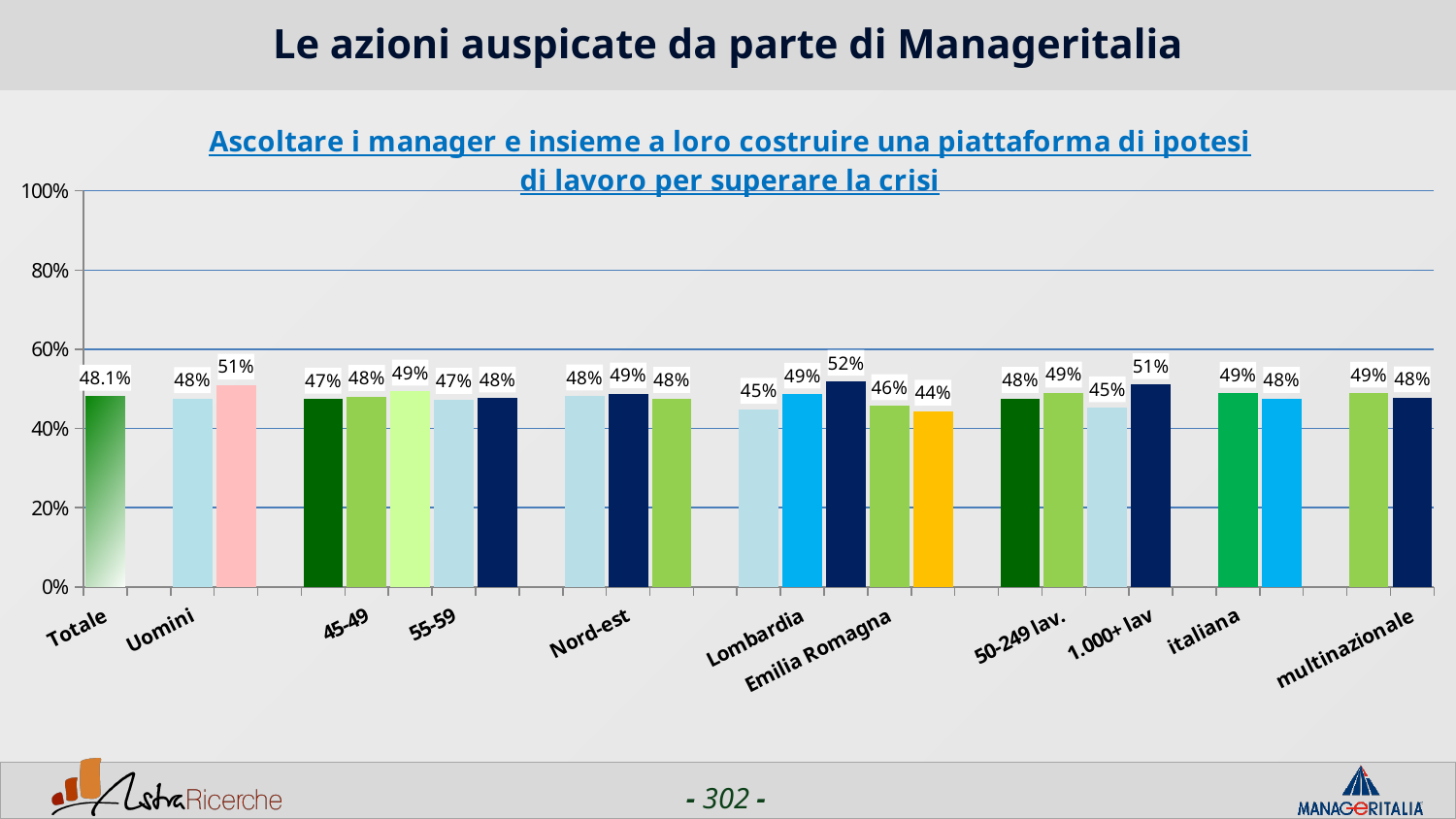
What is the value shown for 1.000+ lav? 51% What is the difference between the value for 1.000+ lav and the value for Emilia Romagna? 5 percentage points What is the value shown for Lombardia? 49% What is the value shown for 55-59? 47% What is the value shown for Totale? 48.1% What kind of chart is shown on the slide? bar chart What is the title of the chart? Ascoltare i manager e insieme a loro costruire una piattaforma di ipotesi di lavoro per superare la crisi Which is larger, the value for 1.000+ lav or the value for 50-249 lav.? 1.000+ lav What is the value shown for Uomini? 48% Is the value for Emilia Romagna greater or less than 40%? greater What is the value shown for Emilia Romagna? 46% Is the value for Totale greater or less than 60%? less